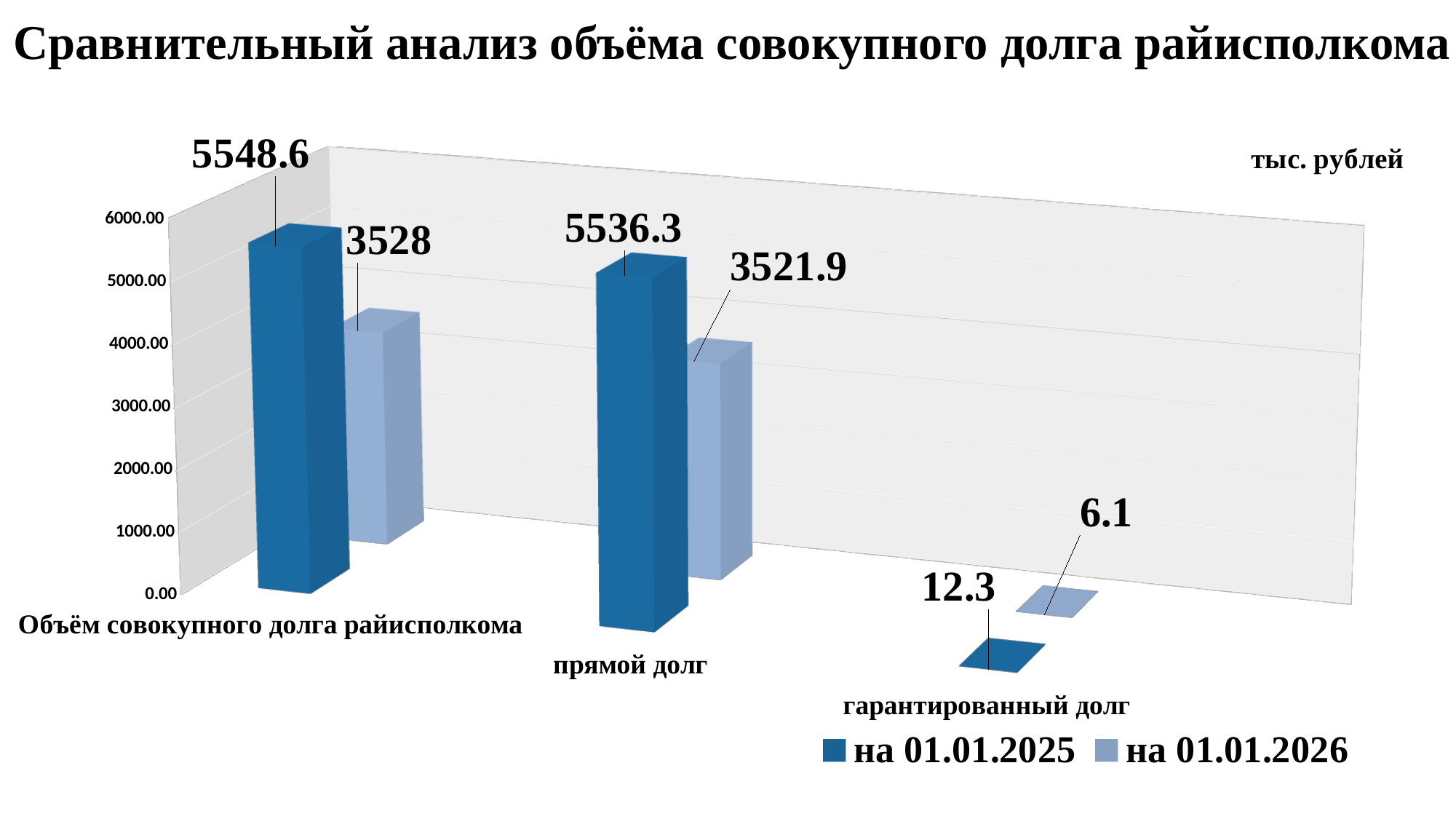
Which is larger for «Объём совокупного долга райисполкома»: the value for «на 01.01.2025» or for «на 01.01.2026»? на 01.01.2025 What is the difference between the «на 01.01.2025» and «на 01.01.2026» values for «прямой долг»? 2014.4 Which category has the lowest value in the series «на 01.01.2026»? гарантированный долг Which category has the highest value in the series «на 01.01.2025»? Объём совокупного долга райисполкома What is the value for «прямой долг» in the series «на 01.01.2026»? 3521.9 What is the difference between the «на 01.01.2025» and «на 01.01.2026» values for «гарантированный долг»? 6.2 What kind of chart is shown on the slide? Bar chart What is the value for «гарантированный долг» in the series «на 01.01.2025»? 12.3 How many categories are shown on the x axis of the chart? 3 What is the value for «Объём совокупного долга райисполкома» in the series «на 01.01.2026»? 3528 How many series does the legend list? 2 What is the value for «Объём совокупного долга райисполкома» in the series «на 01.01.2025»? 5548.6